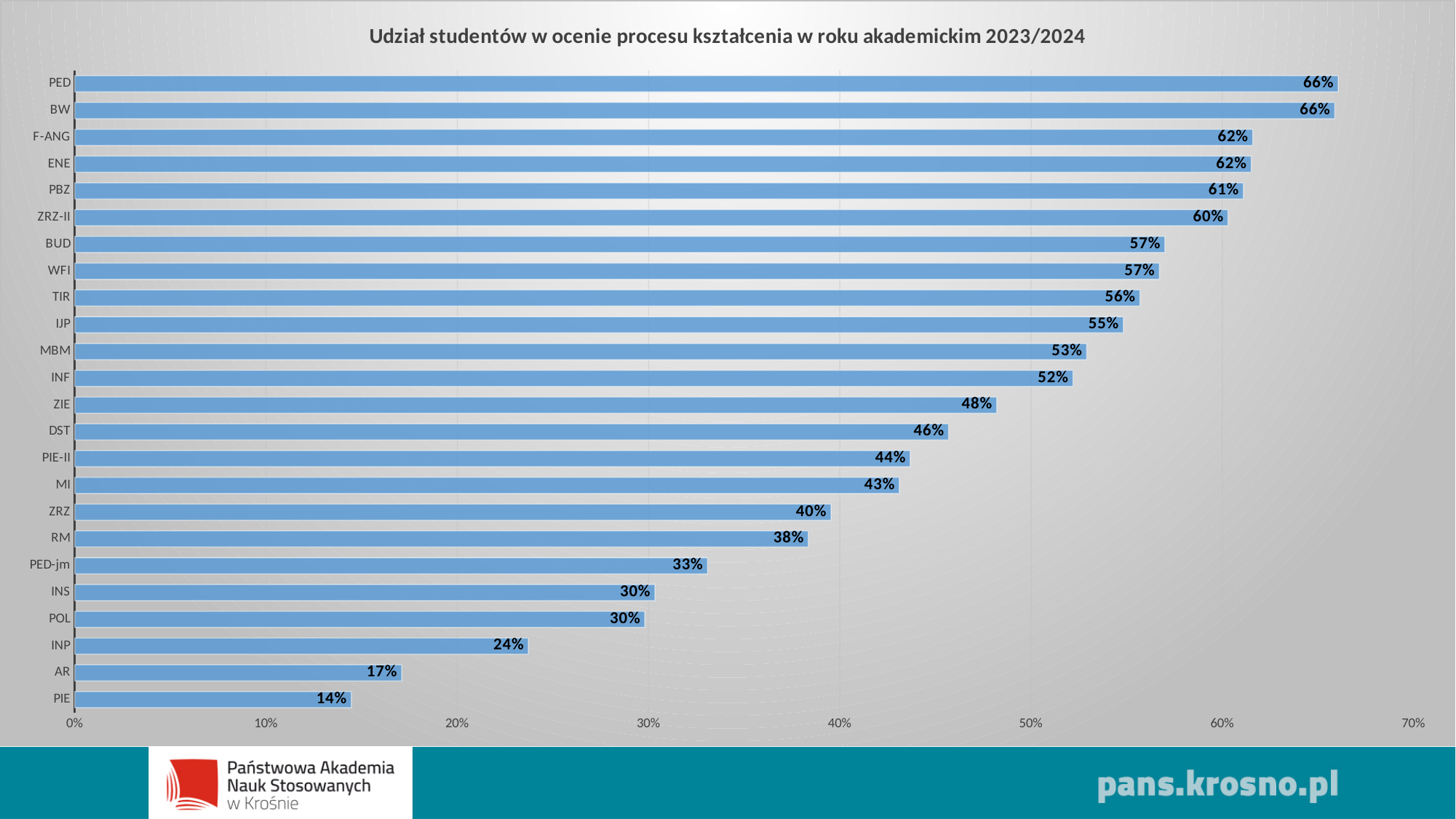
What is the value for ZRZ-II? 60% How many categories are shown in the chart? 24 What is the value for INF? 52% What is the highest value shown on the horizontal axis? 70% Which is larger, the value for AR or the value for ZRZ? ZRZ What is the value for PED-jm? 33% What is the difference between the values for BUD and RM? 19% What kind of chart is shown on the slide? bar chart What is the difference between the values for F-ANG and INP? 38% Which category has the lowest value? PIE What is the title of the chart? Udział studentów w ocenie procesu kształcenia w roku akademickim 2023/2024 Which is larger, the value for MBM or the value for DST? MBM